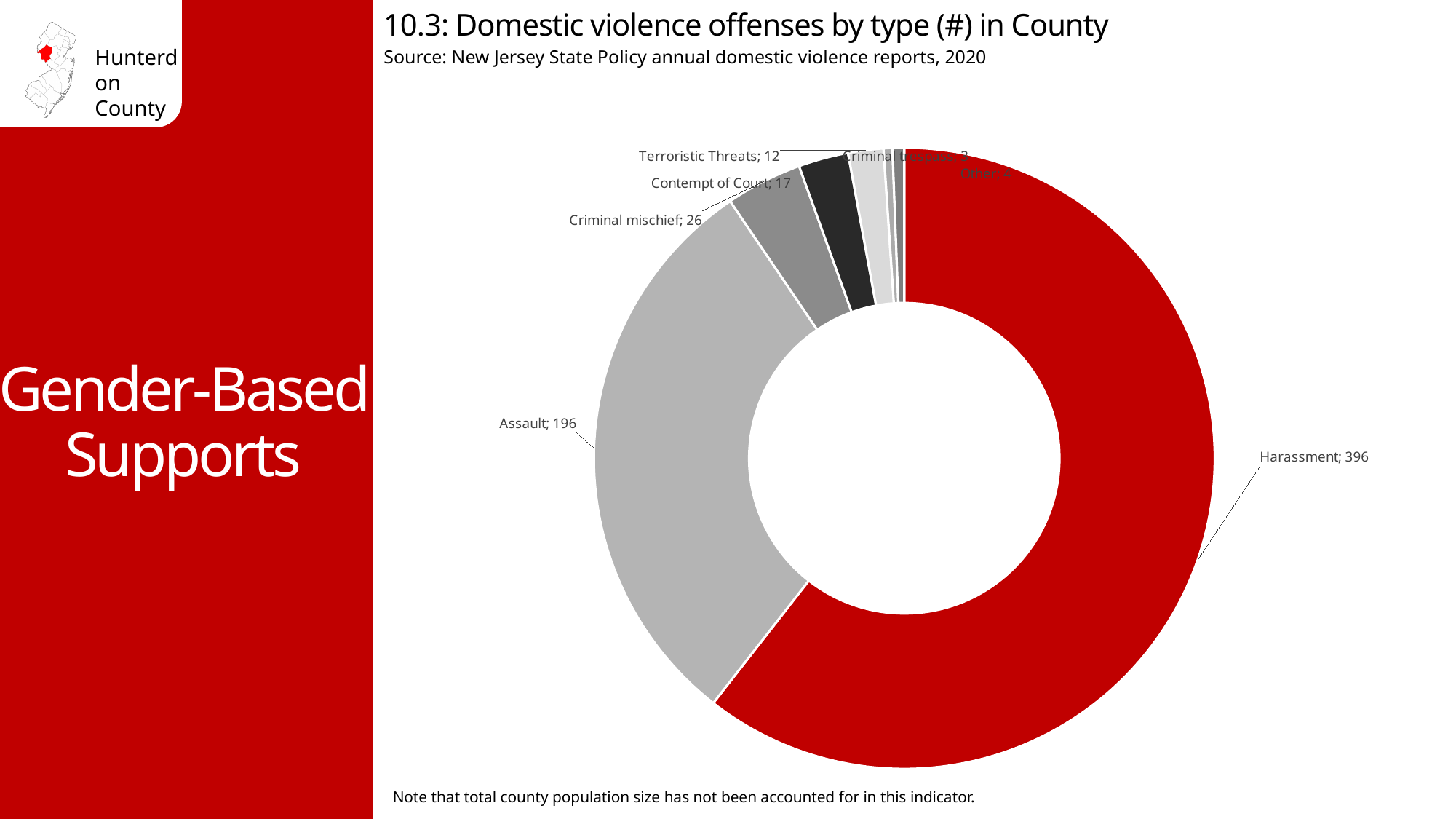
Which offense type has the largest slice? Harassment What is the value for Assault? 196 What is the value for Terroristic Threats? 12 Which is larger, Criminal mischief or Contempt of Court? Criminal mischief How many offense types (slices) are shown in the chart? 7 What year of data does the chart's source line cite? 2020 What is the value for Criminal mischief? 26 What is the difference between the Harassment and Assault values? 200 How many domestic violence offenses of type Harassment are shown? 396 What kind of chart is shown on the slide? doughnut chart What is the value for Other? 4 What is the value for Contempt of Court? 17